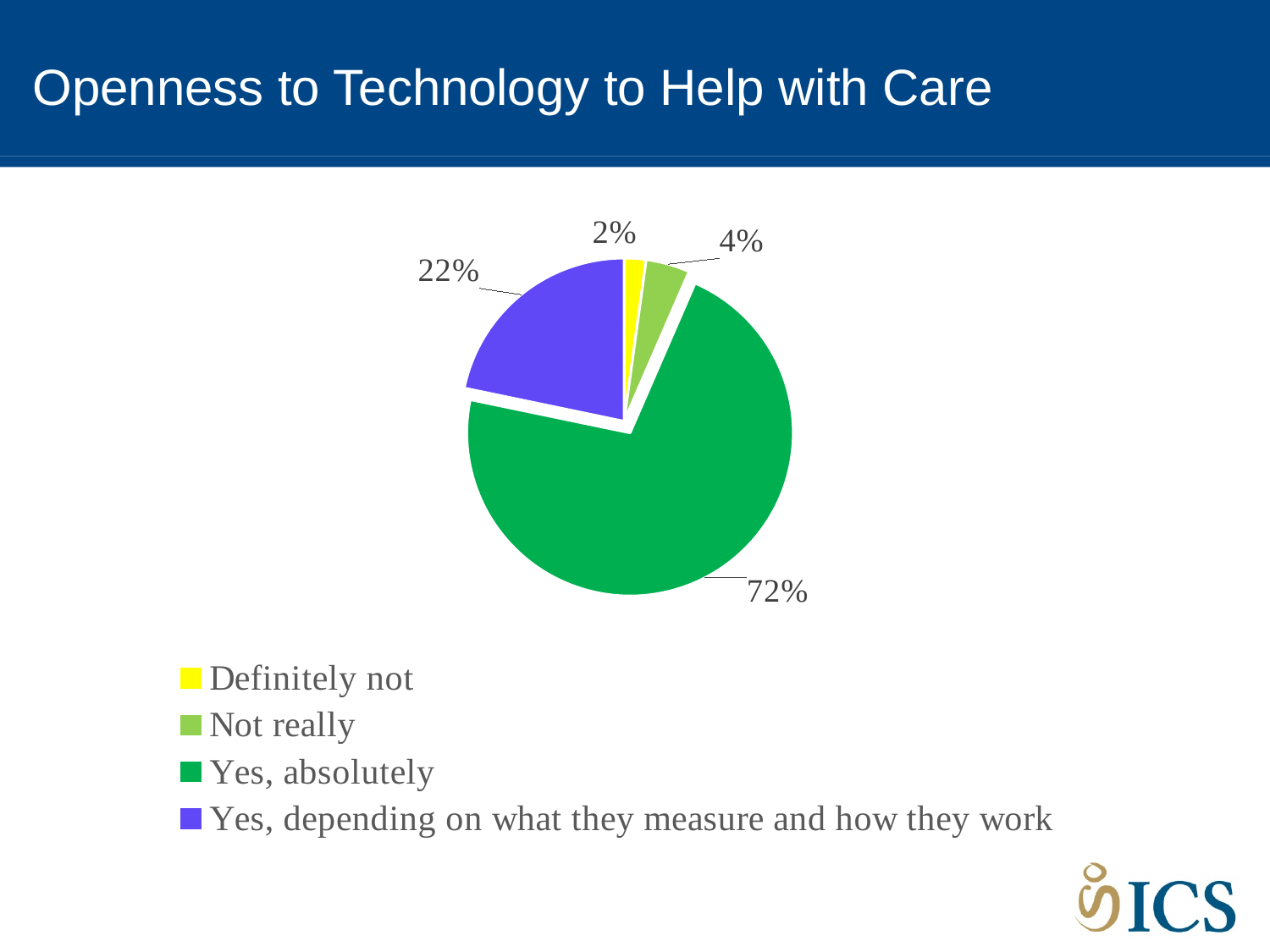
How many slices does the pie chart have? 4 Which response has the largest share of the pie? Yes, absolutely What is the title of the slide containing the pie chart? Openness to Technology to Help with Care What percentage of respondents answered "Yes, depending on what they measure and how they work"? 22% What is the difference in percentage points between "Yes, absolutely" and "Yes, depending on what they measure and how they work"? 50 Which is larger: the share for "Not really" or the share for "Definitely not"? Not really How many entries does the legend list? 4 What kind of chart is shown on the slide? Pie chart Which response has the smallest share of the pie? Definitely not What percentage of respondents answered "Yes, absolutely"? 72% What percentage of respondents answered "Not really"? 4% What percentage of respondents answered "Definitely not"? 2%